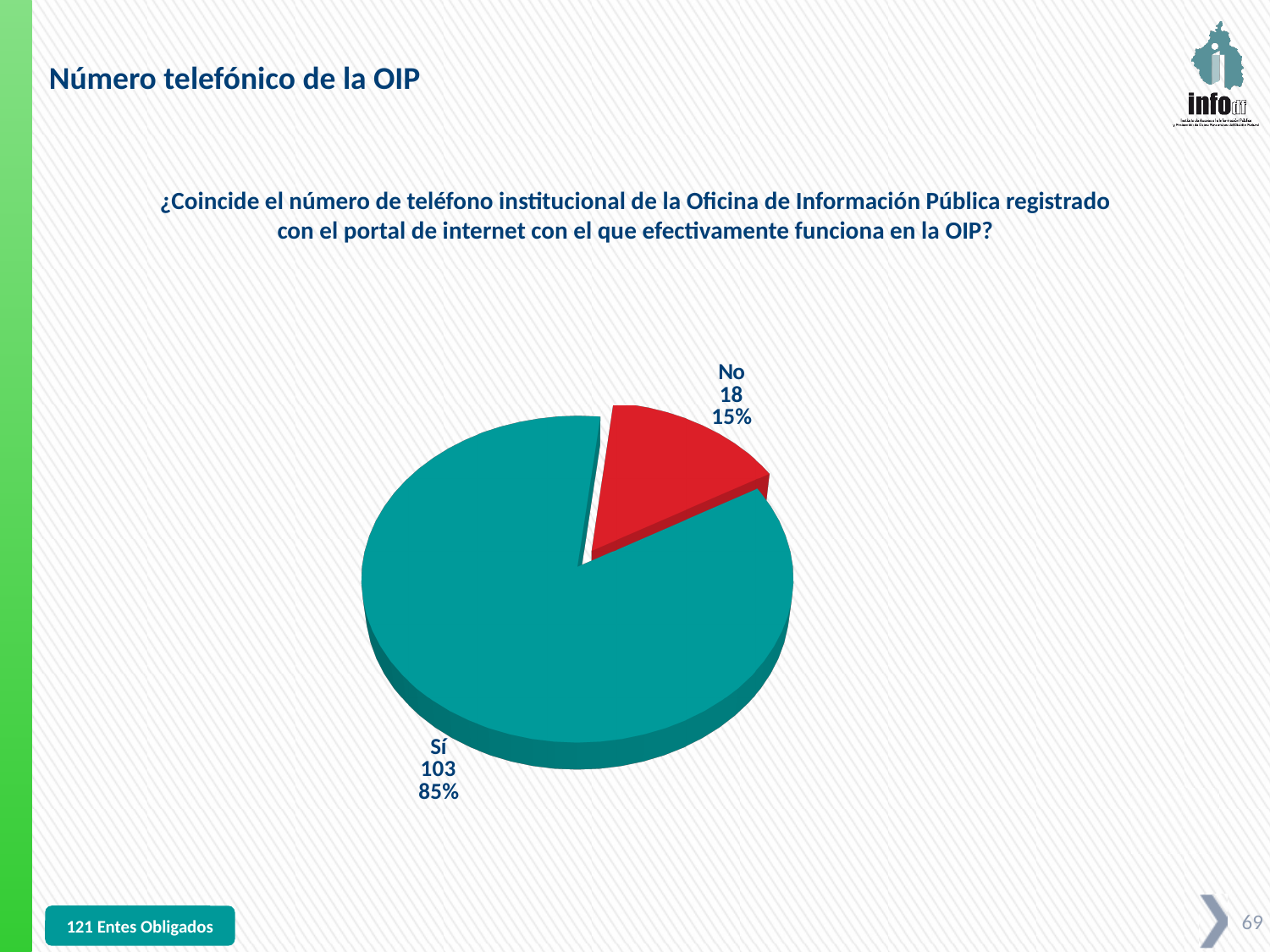
What kind of chart is shown on the slide? pie chart Which slice is the largest? Sí Which slice is the smallest? No What percentage share does the "Sí" slice represent? 85% What is the total of the two slices in the pie chart? 121 What is the value for the "Sí" slice? 103 Which is larger, the value for "Sí" or the value for "No"? Sí What is the difference between the "Sí" and "No" values? 85 What colour is the "No" slice? red What is the value for the "No" slice? 18 What percentage share does the "No" slice represent? 15% How many slices does the pie chart have? 2